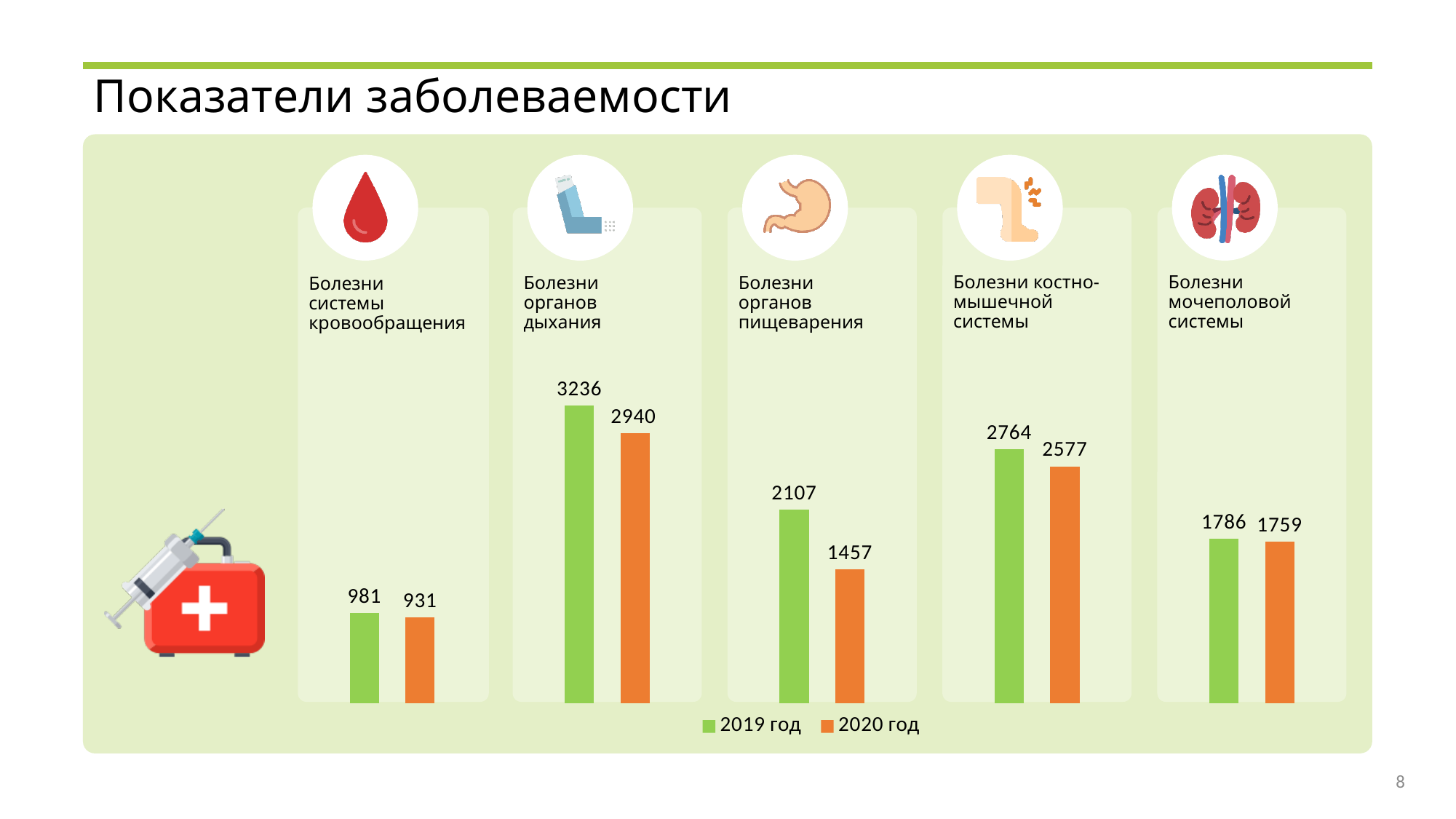
What is the 2019 год value for Болезни органов дыхания? 3236 What is the title of the slide? Показатели заболеваемости How many disease categories are shown in the chart? 5 What is the difference between the 2019 год and 2020 год values for Болезни органов пищеварения? 650 What kind of chart is shown on the slide? Bar chart Which category has the lowest 2020 год value? Болезни системы кровообращения How many series does the legend list? 2 Which category has the highest 2019 год value? Болезни органов дыхания Which is larger: the 2020 год value for Болезни костно-мышечной системы or the 2019 год value for Болезни органов пищеварения? 2020 год value for Болезни костно-мышечной системы What is the difference between the 2019 год and 2020 год values for Болезни костно-мышечной системы? 187 What is the 2020 год value for Болезни органов пищеварения? 1457 What is the 2020 год value for Болезни системы кровообращения? 931